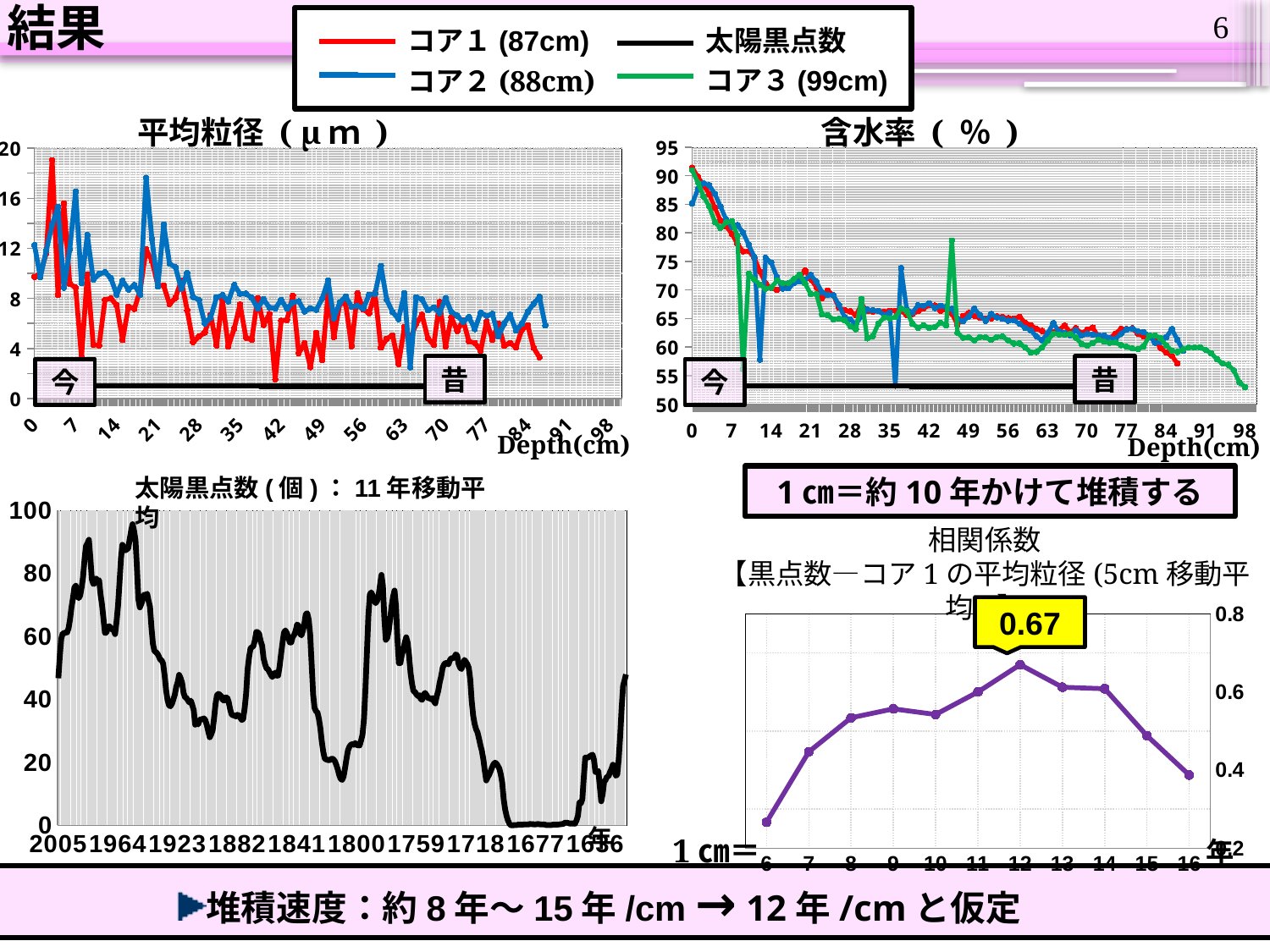
What kind of chart is the 相関係数 chart at the bottom right? line chart How many series does the legend at the top of the slide list? 4 In the 相関係数 chart at the bottom right, is the value at 6 greater or less than 0.4? less In the 相関係数 chart at the bottom right, do the values rise or fall from 6 to 12 on the x axis? rise In the 相関係数 chart at the bottom right, at which x-axis value is the correlation coefficient highest? 12 How many data points are plotted in the 相関係数 chart at the bottom right? 11 In the 相関係数 chart at the bottom right, which has the larger value, 13 or 15? 13 In the 相関係数 chart at the bottom right, at which x-axis value is the correlation coefficient lowest? 6 In the legend at the top of the slide, what colour is the line for コア3 (99cm)? green In the 太陽黒点数 chart at the bottom left, is the value at 2005 greater or less than 60? less In the 相関係数 chart at the bottom right, what is the correlation coefficient when 1cm = 12年? 0.67